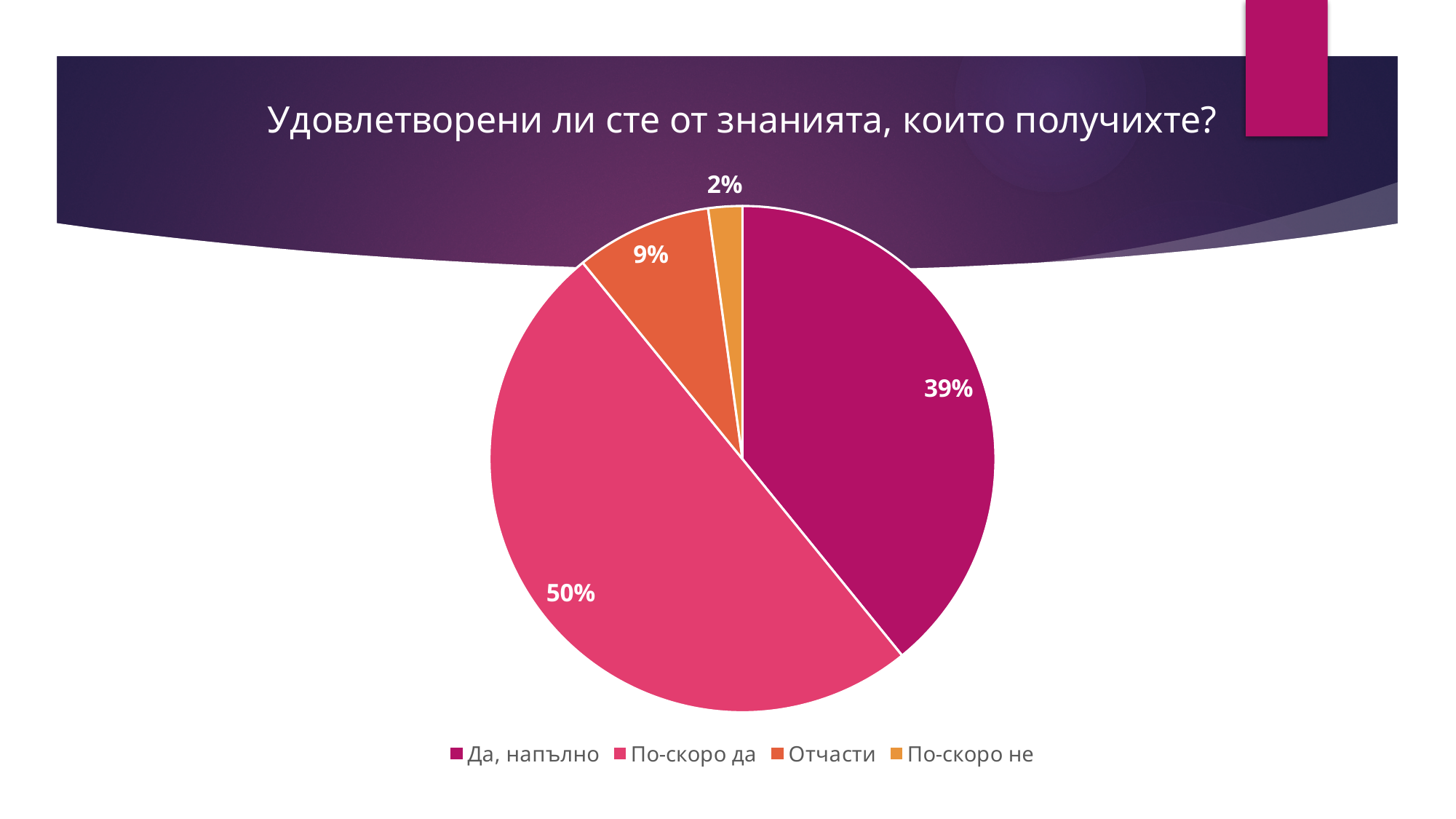
What share of the pie does "По-скоро да" have? 50% What share of the pie does "По-скоро не" have? 2% Which category has the largest slice of the pie? По-скоро да Which is larger, the share for "Отчасти" or the share for "По-скоро не"? Отчасти What kind of chart is shown on the slide? pie chart What is the title of the chart? Удовлетворени ли сте от знанията, които получихте? What colour is the slice for "По-скоро не"? orange What is the difference between the shares of "По-скоро да" and "Да, напълно"? 11% What share of the pie does "Да, напълно" have? 39% How many categories does the legend list? 4 Which category has the smallest slice of the pie? По-скоро не What share of the pie does "Отчасти" have? 9%